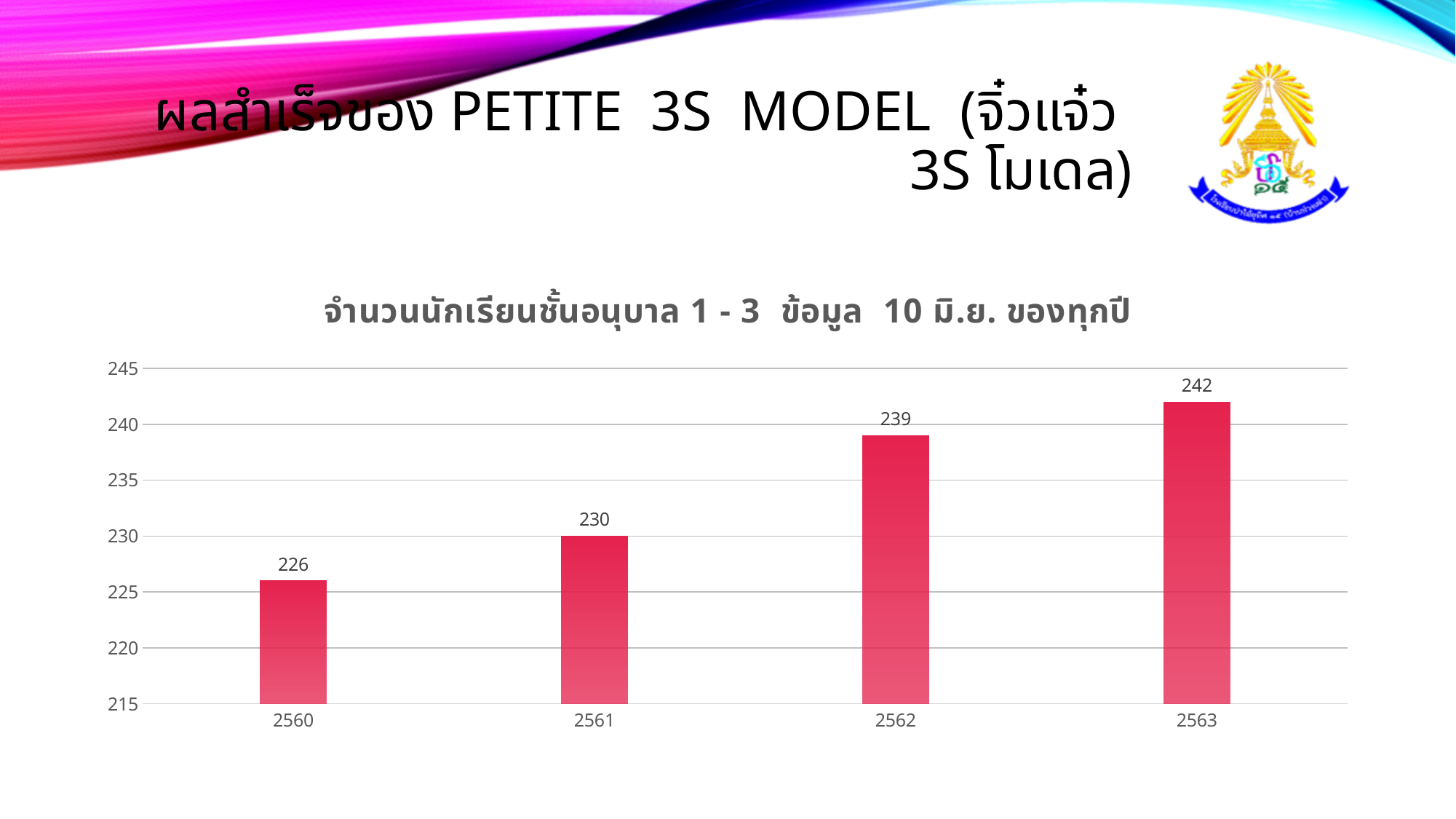
What is the value for 2560? 226 How many years are shown on the x axis? 4 Which is larger, the value for 2561 or the value for 2562? 2562 What is the value for 2563? 242 What is the value for 2562? 239 What kind of chart is shown on the slide? bar chart What is the difference between the values for 2562 and 2561? 9 Is the value for 2561 greater or less than 235? less Do the values rise or fall from 2560 to 2563? rise What is the difference between the values for 2563 and 2560? 16 Which year has the lowest value? 2560 Which year has the highest value? 2563